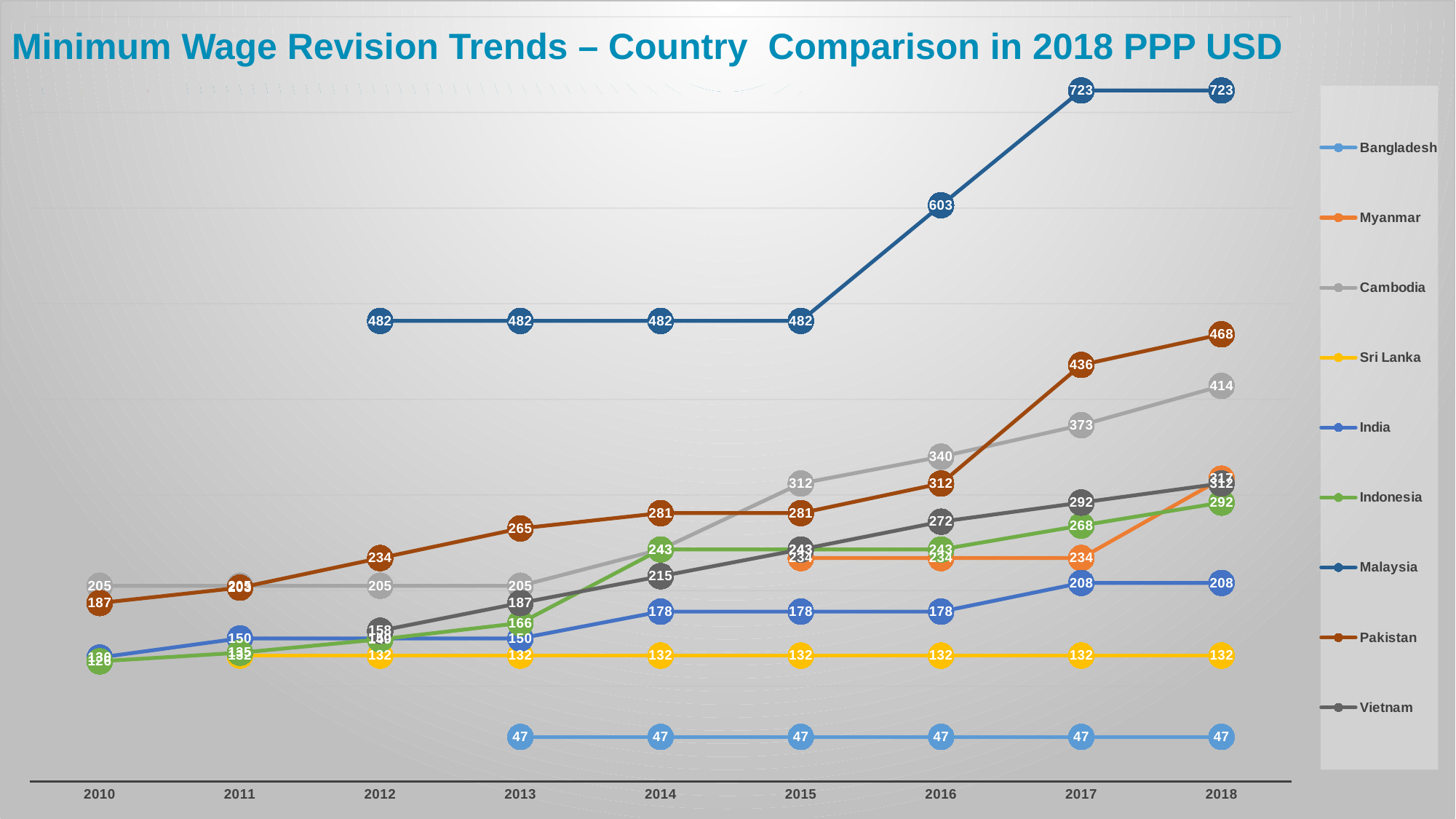
What is the value for Vietnam in 2018? 312 What is the difference between the values for Malaysia and Pakistan in 2018? 255 Which country has the lowest value in 2018? Bangladesh In 2017, which is larger: the value for Cambodia or the value for Pakistan? Pakistan By how much did Malaysia's value increase from 2015 to 2016? 121 How many countries does the legend list? 9 Does the value for Pakistan rise or fall from 2010 to 2018? Rise What kind of chart is shown on the slide? Line chart What is the value for Pakistan in 2017? 436 Which country has the highest value in 2018? Malaysia What is the value for Cambodia in 2018? 414 What is the value for Malaysia in 2018? 723